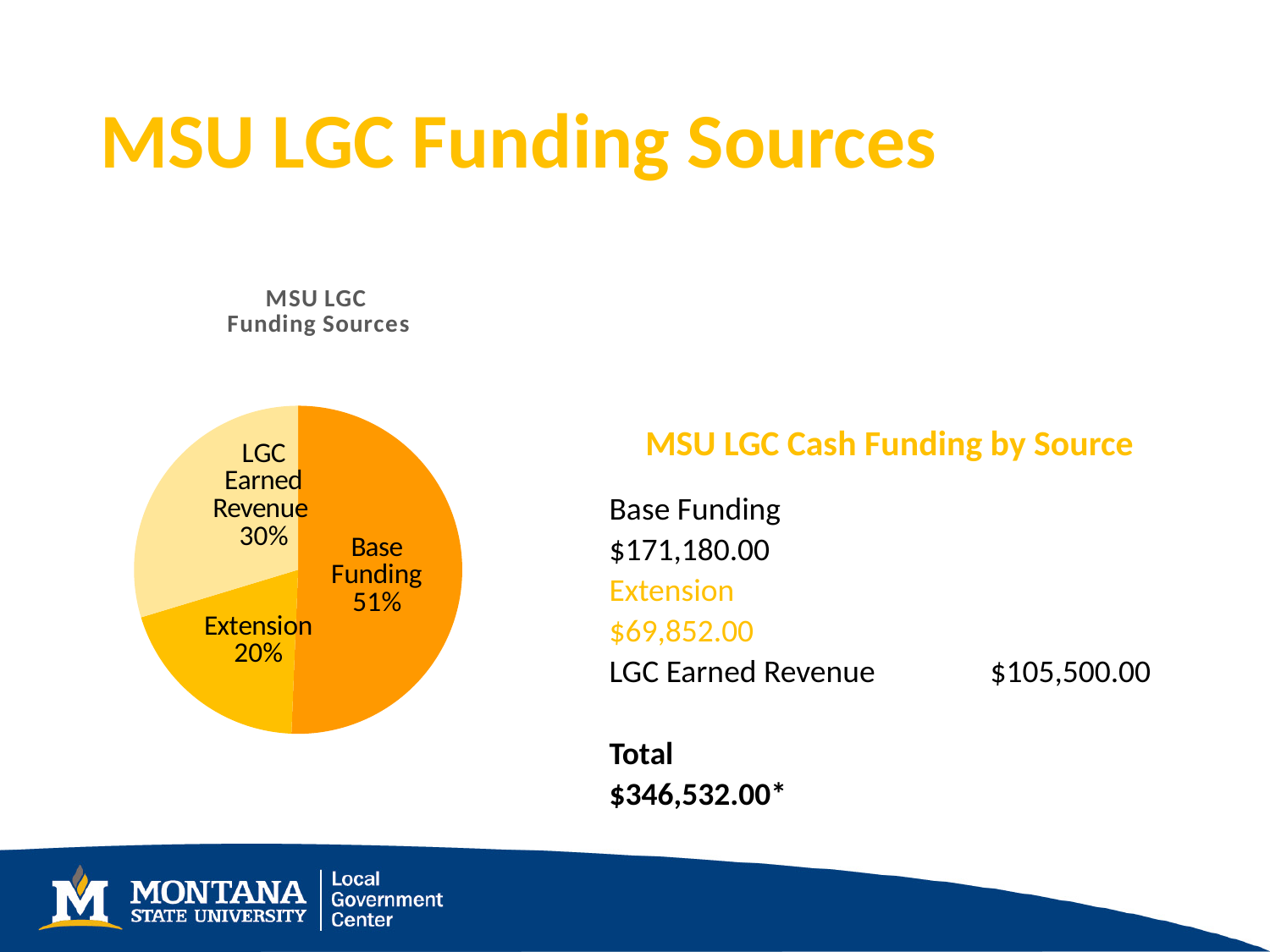
How many slices does the pie chart have? 3 What is the difference in percentage points between the Base Funding slice and the LGC Earned Revenue slice? 21 What is the difference in percentage points between the LGC Earned Revenue slice and the Extension slice? 10 Which slice of the pie is the smallest? Extension Which slice of the pie is the largest? Base Funding Which slice is larger, LGC Earned Revenue or Extension? LGC Earned Revenue What share of the pie does LGC Earned Revenue represent? 30% What type of chart is shown on the slide? pie chart What share of the pie does Base Funding represent? 51% What share of the pie does Extension represent? 20% What is the title of the chart? MSU LGC Funding Sources Is the share for Base Funding greater or less than 50%? greater